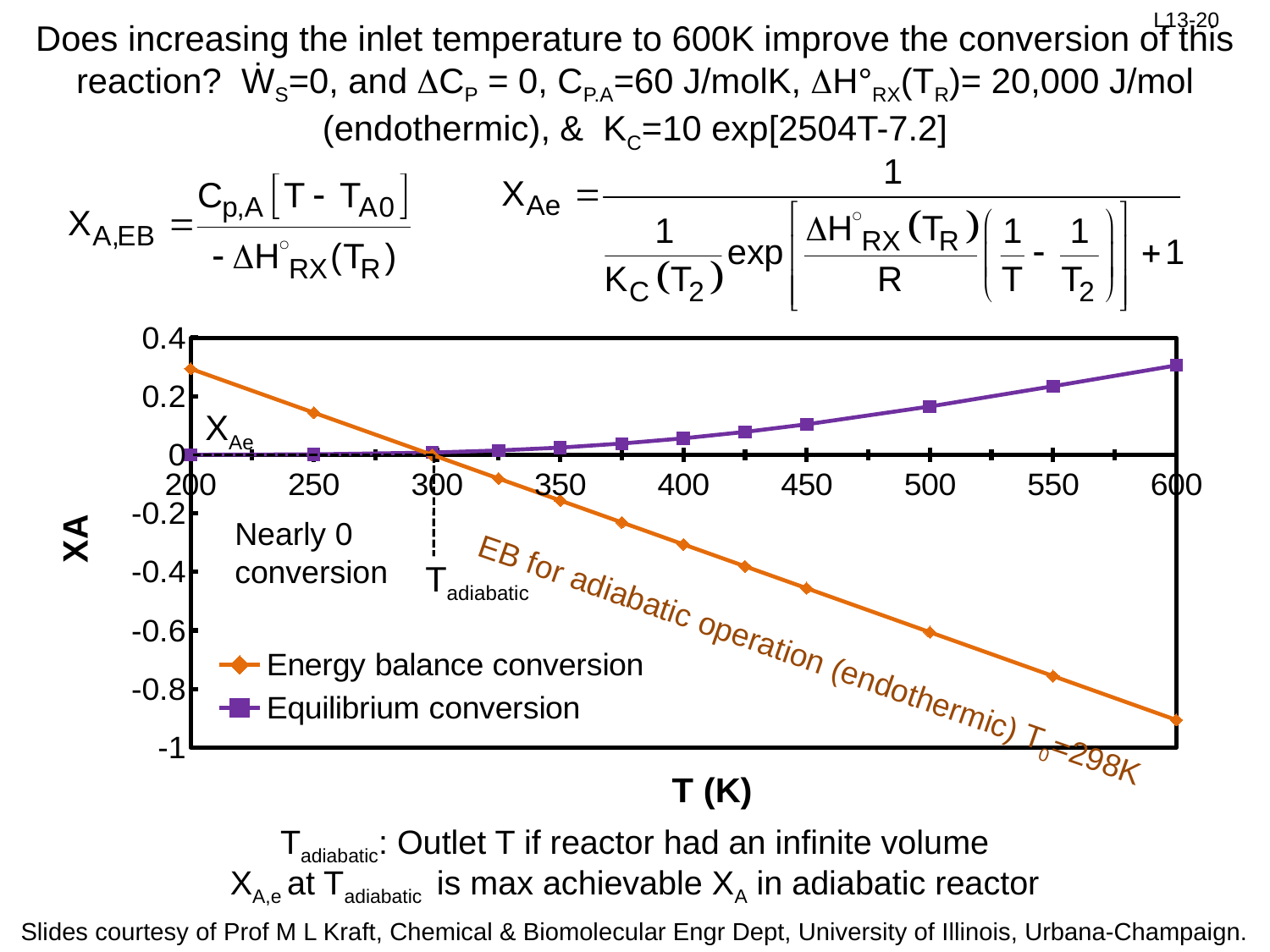
At T = 200, which series has the larger value, Energy balance conversion or Equilibrium conversion? Energy balance conversion Is the Energy balance conversion at T = 600 greater or less than -0.8? less Does the Energy balance conversion rise or fall as T increases from 200 to 600? fall At T = 600, which series has the larger value, Energy balance conversion or Equilibrium conversion? Equilibrium conversion What is the label of the x axis? T (K) Is the Energy balance conversion at T = 500 greater or less than -0.4? less How many series does the chart's legend list? 2 What kind of chart is shown on the slide? line chart Does the Equilibrium conversion rise or fall as T increases from 200 to 600? rise What are the two series named in the legend? Energy balance conversion and Equilibrium conversion Is the Equilibrium conversion at T = 600 greater or less than 0.2? greater